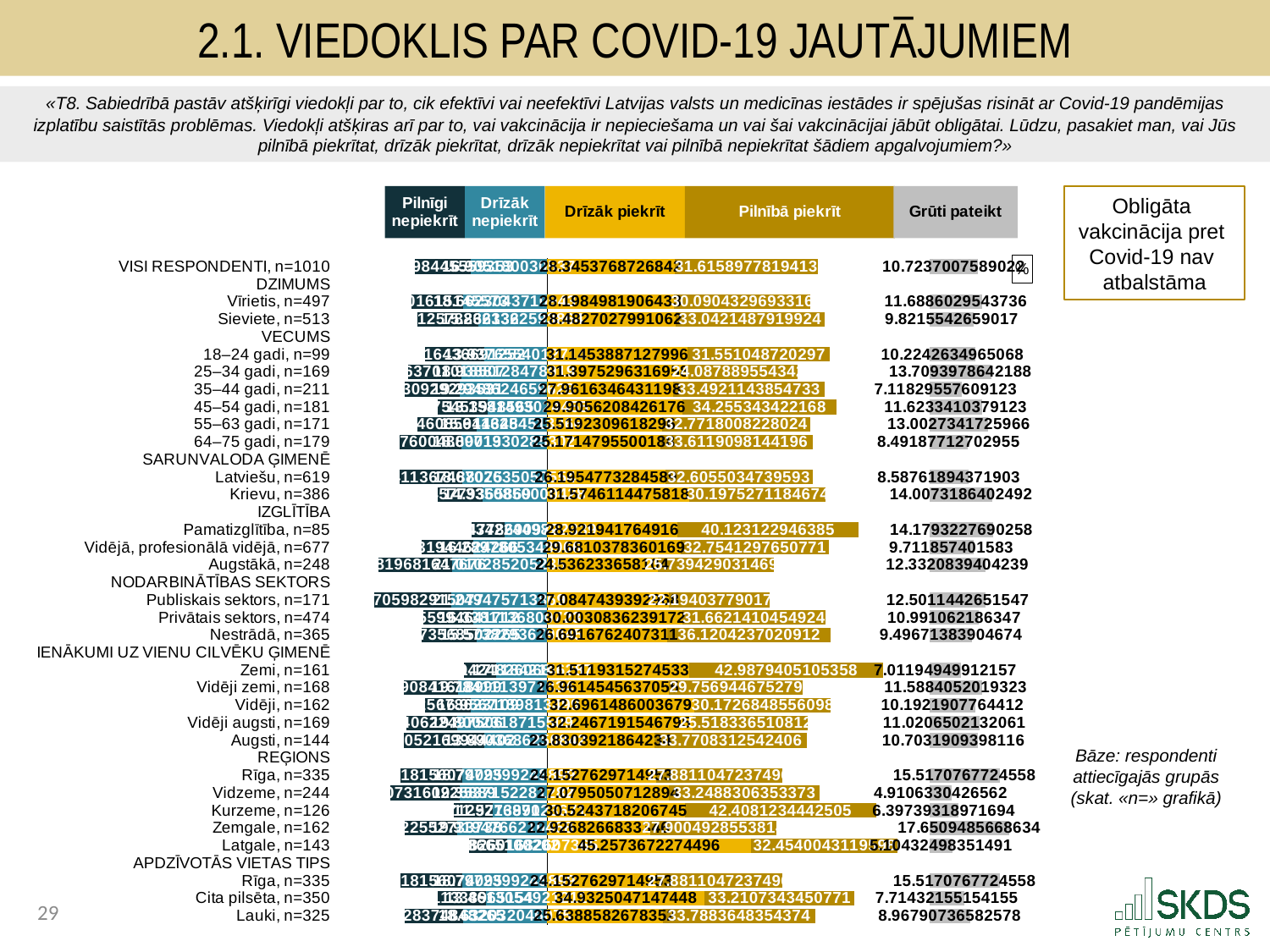
How many series does the chart legend list? 5 How many respondents (n) are in the VISI RESPONDENTI group? 1010 Among the income groups (IENĀKUMI UZ VIENU CILVĒKU ĢIMENĒ), which has the largest 'Pilnībā piekrīt' share? Zemi, n=161 Which has the larger 'Drīzāk piekrīt' share: Latgale, n=143 or Rīga, n=335 (REĢIONS)? Latgale, n=143 Which has the larger 'Grūti pateikt' share: Zemgale, n=162 or Vidzeme, n=244? Zemgale, n=162 What is the 'Pilnībā piekrīt' value for the Zemi, n=161 income group? 42.9879405105358 What statement is shown in the box to the right of the chart? Obligāta vakcinācija pret Covid-19 nav atbalstāma What kind of chart is shown on the slide? Stacked horizontal bar chart How many regions are listed under the REĢIONS section of the chart? 5 What is the 'Drīzāk piekrīt' value for Latgale, n=143? 45.2573672274496 What are the five response categories listed in the chart legend? Pilnīgi nepiekrīt, Drīzāk nepiekrīt, Drīzāk piekrīt, Pilnībā piekrīt, Grūti pateikt How many respondents (n) are in the Vīrietis group? 497